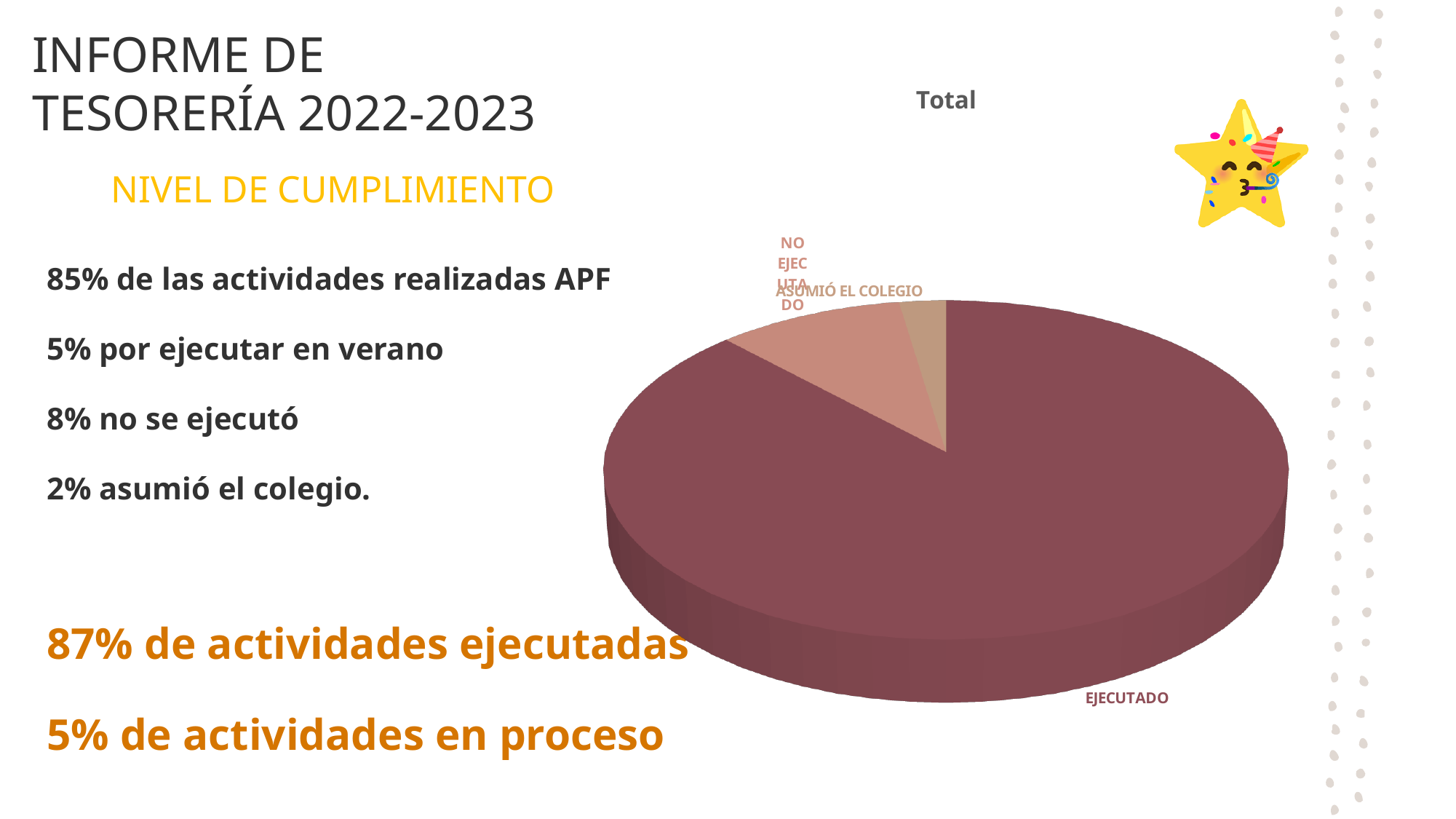
What kind of chart is shown on the slide? Pie chart What is the title of the chart? Total Which slice is smaller, EJECUTADO or ASUMIÓ EL COLEGIO? ASUMIÓ EL COLEGIO How many slices does the pie chart have? 3 Which slice is larger, NO EJECUTADO or ASUMIÓ EL COLEGIO? NO EJECUTADO Which slice is larger, EJECUTADO or NO EJECUTADO? EJECUTADO Which slice of the pie chart is the largest? EJECUTADO What are the labels of the three slices in the pie chart? EJECUTADO, NO EJECUTADO, ASUMIÓ EL COLEGIO Which slice of the pie chart is the smallest? ASUMIÓ EL COLEGIO